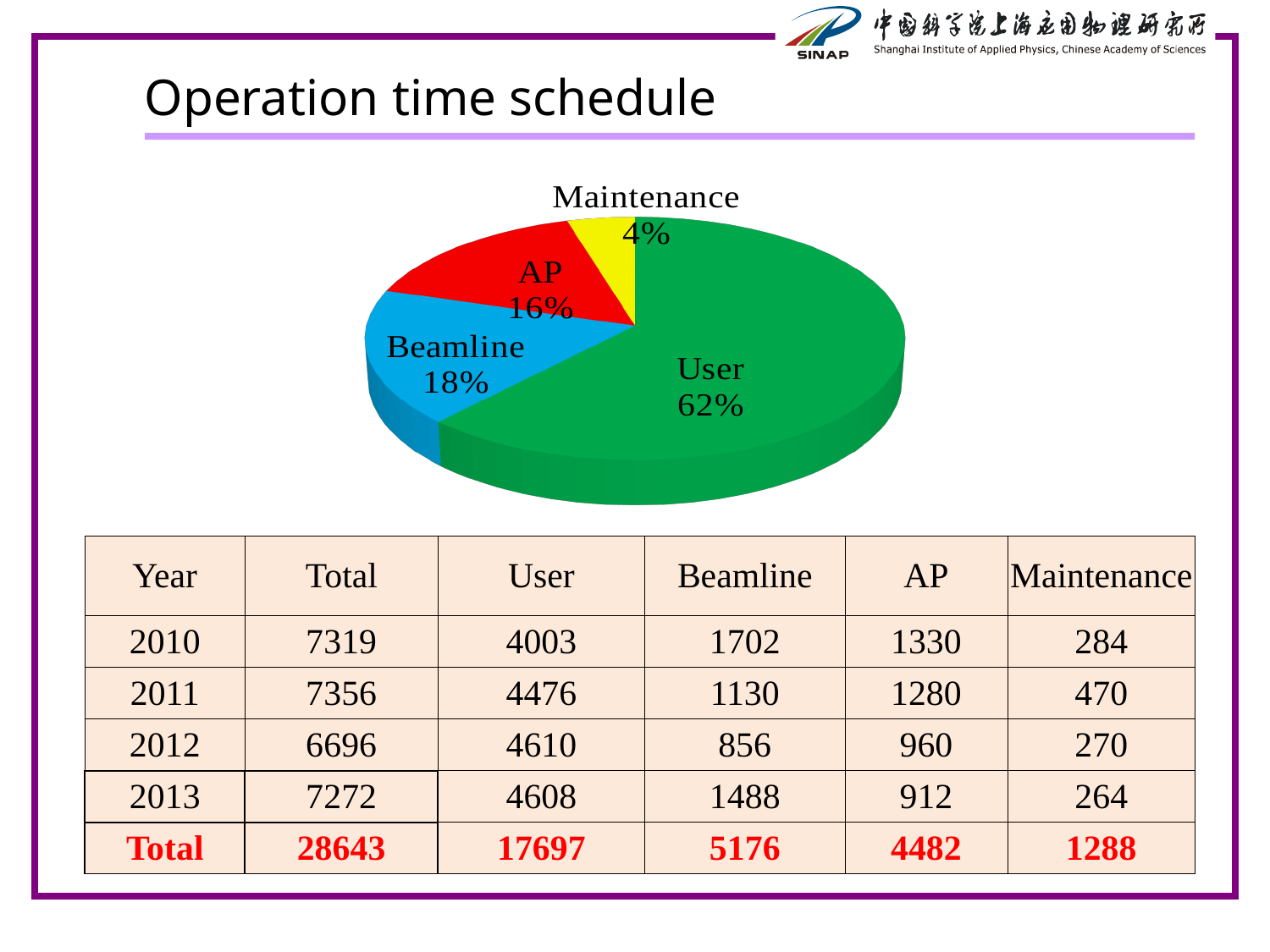
What share of the pie chart is labelled User? 62% What kind of chart is shown on the slide? pie chart How many slices does the pie chart have? 4 What colour is the User slice in the pie chart? green What is the difference in percentage points between the User slice and the Beamline slice? 44 What share of the pie chart is labelled Beamline? 18% What is the difference in percentage points between the AP slice and the Maintenance slice? 12 What share of the pie chart is labelled Maintenance? 4% Which slice of the pie chart is the smallest? Maintenance Which slice is larger in the pie chart, Beamline or AP? Beamline Which slice of the pie chart is the largest? User